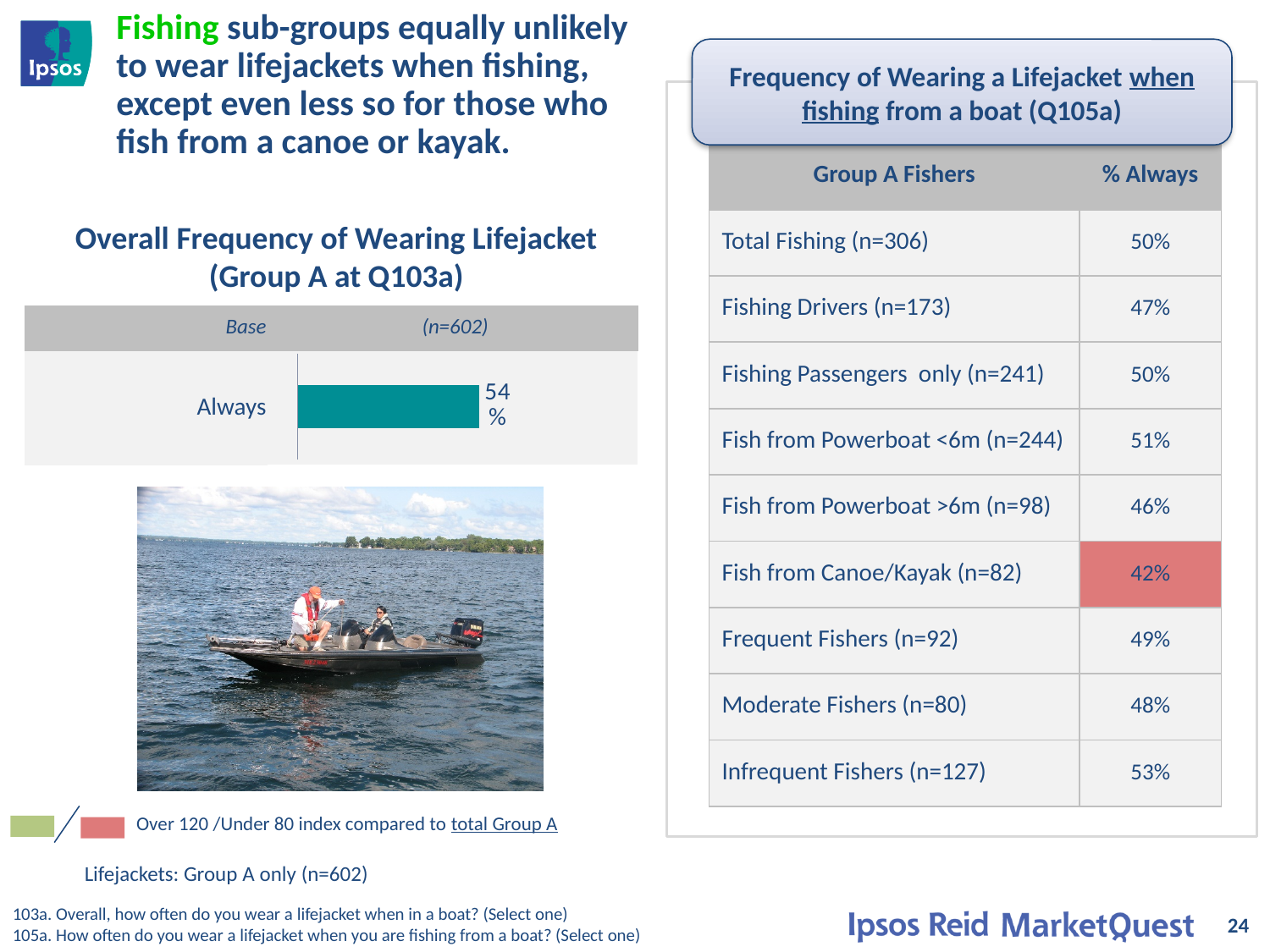
What base size is shown above the bar in the chart 'Overall Frequency of Wearing Lifejacket (Group A at Q103a)'? n=602 How many categories are plotted in the chart 'Overall Frequency of Wearing Lifejacket (Group A at Q103a)'? 1 What kind of chart is 'Overall Frequency of Wearing Lifejacket (Group A at Q103a)'? bar chart What is the title of the bar chart on the left side of the slide? Overall Frequency of Wearing Lifejacket (Group A at Q103a) What is the label of the single bar in the chart 'Overall Frequency of Wearing Lifejacket (Group A at Q103a)'? Always In the chart 'Overall Frequency of Wearing Lifejacket (Group A at Q103a)', what is the value for 'Always'? 54%